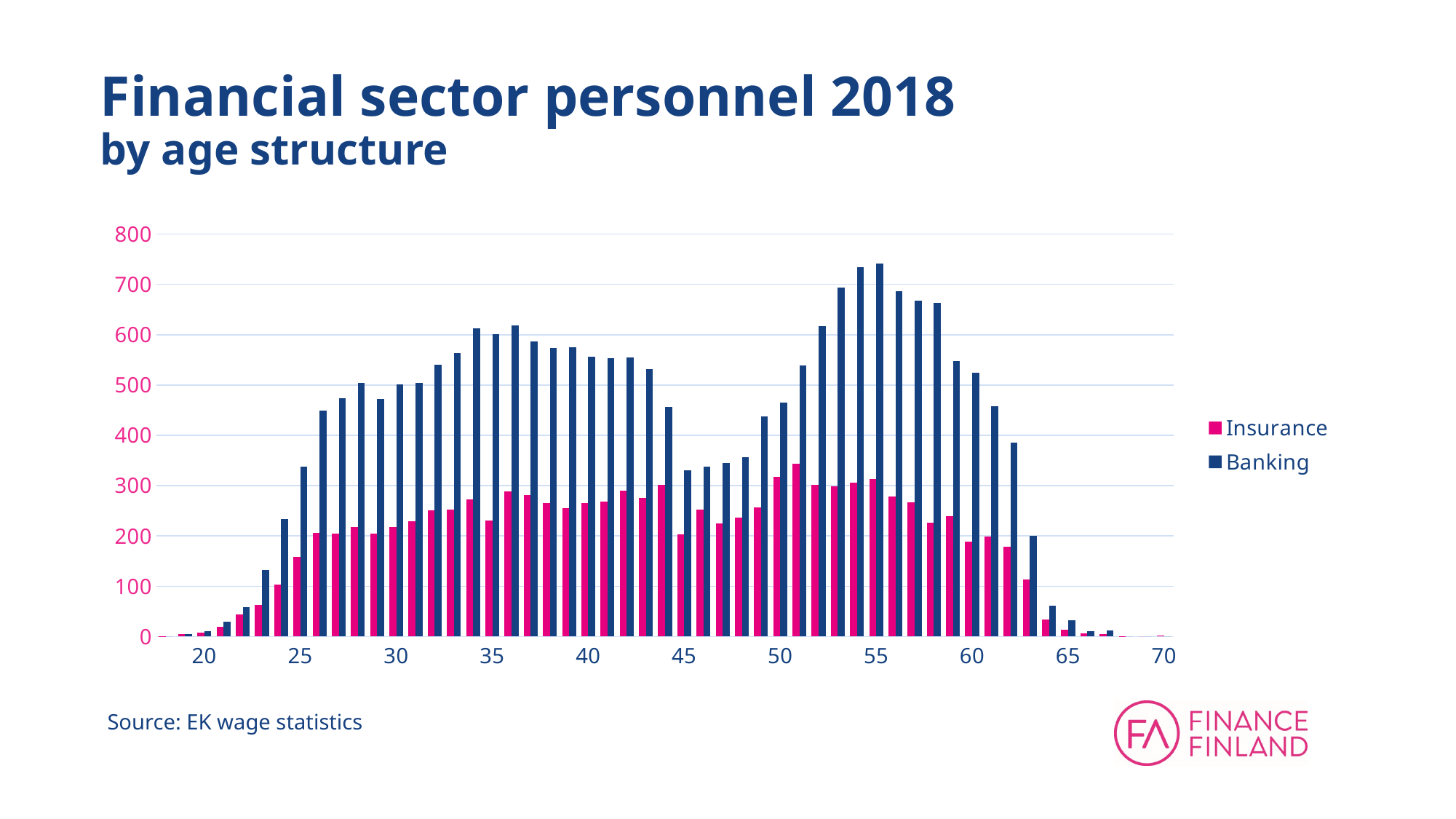
Which two series are listed in the legend? Insurance and Banking Is the Banking value at age 45 greater or less than 400? less Which is larger, the Banking value at age 40 or the Banking value at age 45? Age 40 Do the Banking values rise or fall from age 45 to age 55? Rise Is the Banking value at age 64 greater or less than 100? less What kind of chart is shown on the slide? Bar chart How many series does the legend list? 2 Is the Banking value at age 55 greater or less than 700? greater At age 45, which series has the larger value, Insurance or Banking? Banking Which colour represents the Banking series? Dark blue